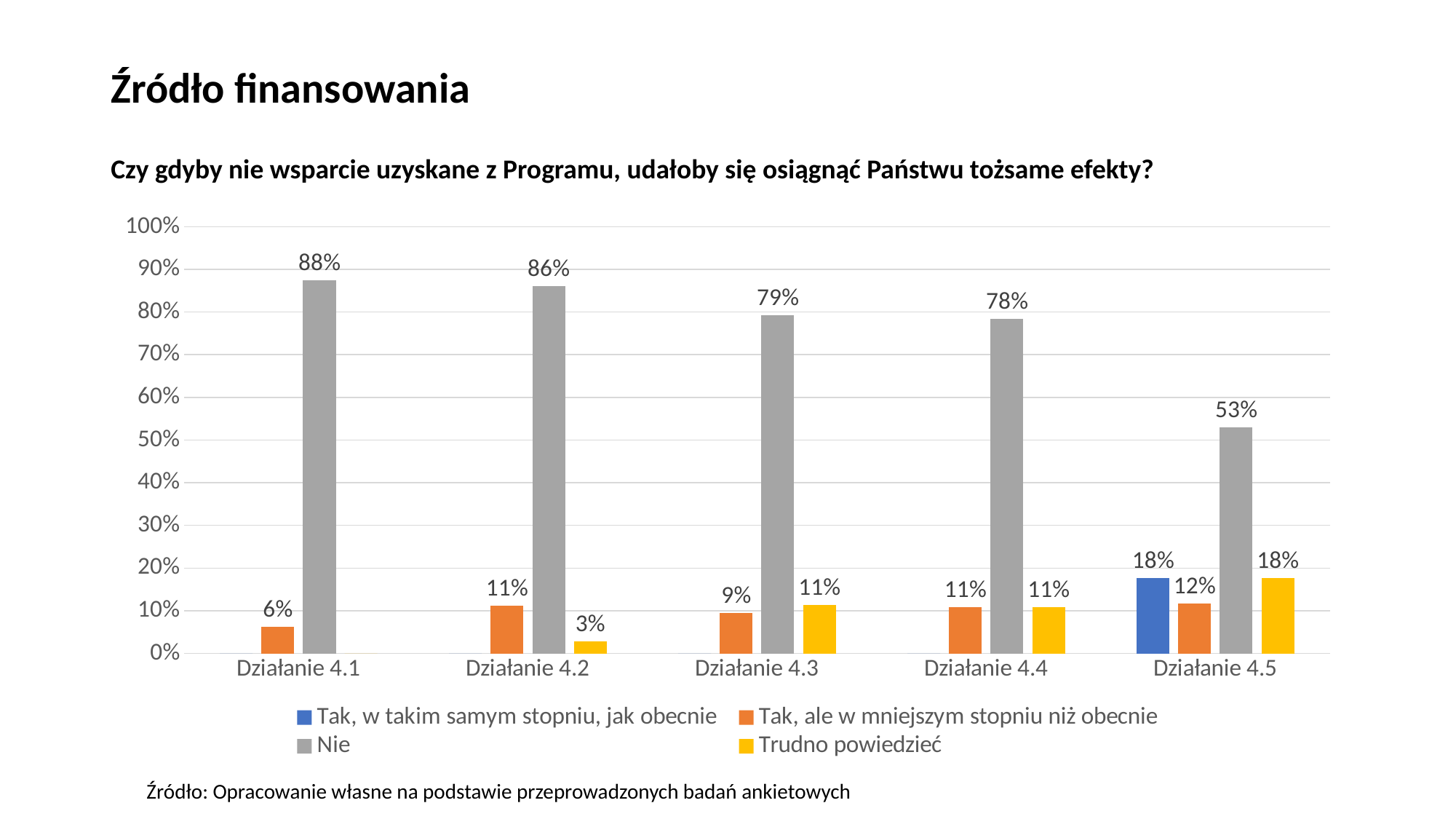
How many series does the legend list? 4 Does the "Nie" series rise or fall from Działanie 4.1 to Działanie 4.5? Fall How many categories are shown on the x axis? 5 What is the value of "Nie" for Działanie 4.1? 88% What is the value of "Tak, w takim samym stopniu, jak obecnie" for Działanie 4.5? 18% Which is larger: "Nie" for Działanie 4.2 or "Nie" for Działanie 4.3? Działanie 4.2 What is the value of "Tak, ale w mniejszym stopniu niż obecnie" for Działanie 4.3? 9% Which category has the highest value for "Nie"? Działanie 4.1 What is the difference between the "Nie" values for Działanie 4.1 and Działanie 4.5? 35% What kind of chart is shown on the slide? Bar chart What is the value of "Trudno powiedzieć" for Działanie 4.2? 3% Which category has the lowest value for "Nie"? Działanie 4.5